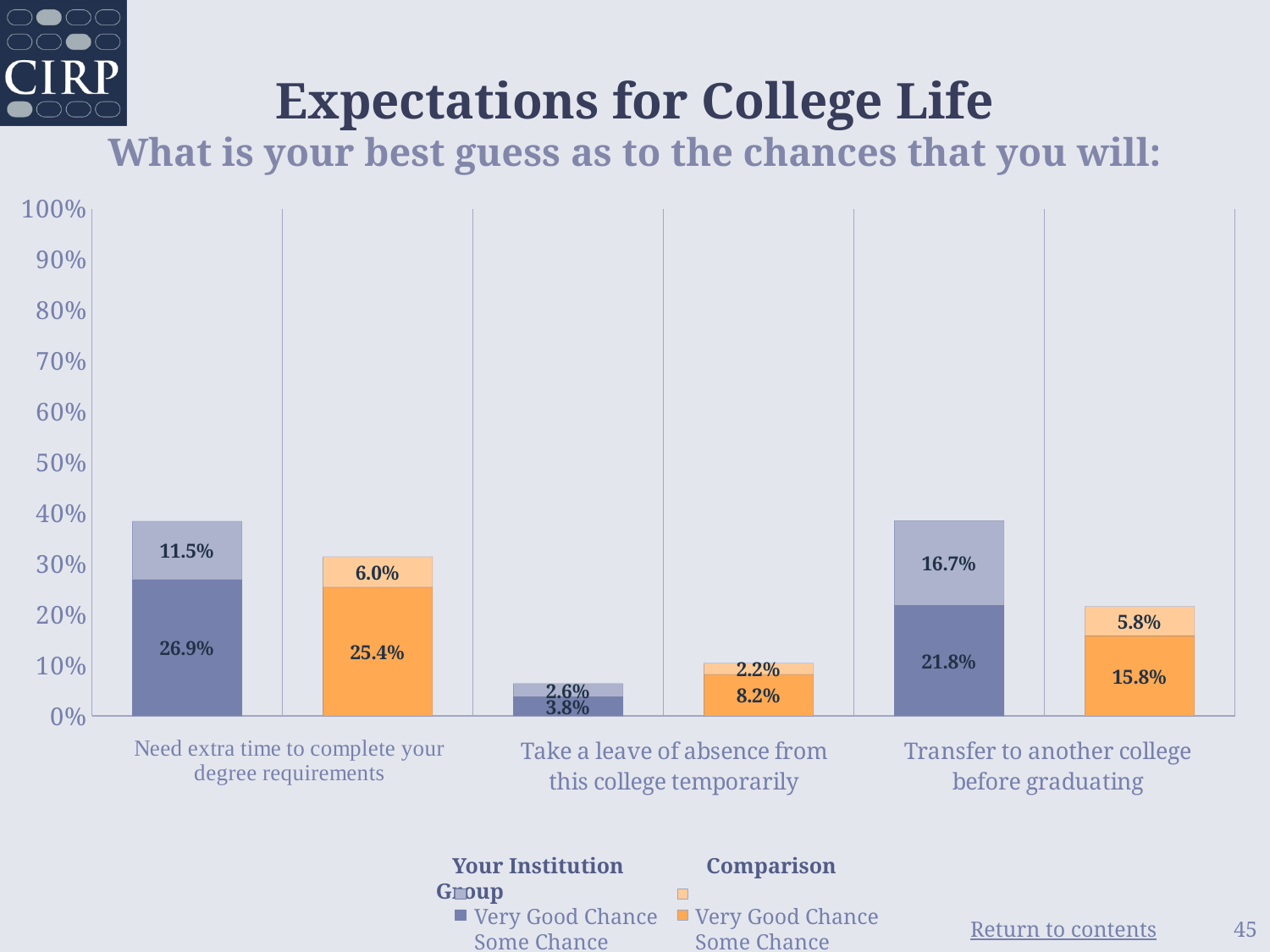
Which category has the highest 'Some Chance' value for Your Institution? Need extra time to complete your degree requirements What is the difference between the 'Very Good Chance' values for Your Institution and the Comparison Group for 'Transfer to another college before graduating'? 10.9% Which category has the lowest 'Very Good Chance' value for Your Institution? Take a leave of absence from this college temporarily What kind of chart is shown on the slide? Stacked bar chart What is the 'Some Chance' value for the Comparison Group for 'Transfer to another college before graduating'? 15.8% What is the total of the stacked bar for Your Institution for 'Transfer to another college before graduating'? 38.5% How many categories are shown on the x axis? 3 What is the 'Very Good Chance' value for Your Institution for 'Need extra time to complete your degree requirements'? 11.5% What is the total of the stacked bar for the Comparison Group for 'Need extra time to complete your degree requirements'? 31.4% How many series does the legend list? 4 For 'Take a leave of absence from this college temporarily', which is larger: the 'Very Good Chance' value for Your Institution or for the Comparison Group? Your Institution What is the 'Very Good Chance' value for the Comparison Group for 'Take a leave of absence from this college temporarily'? 2.2%